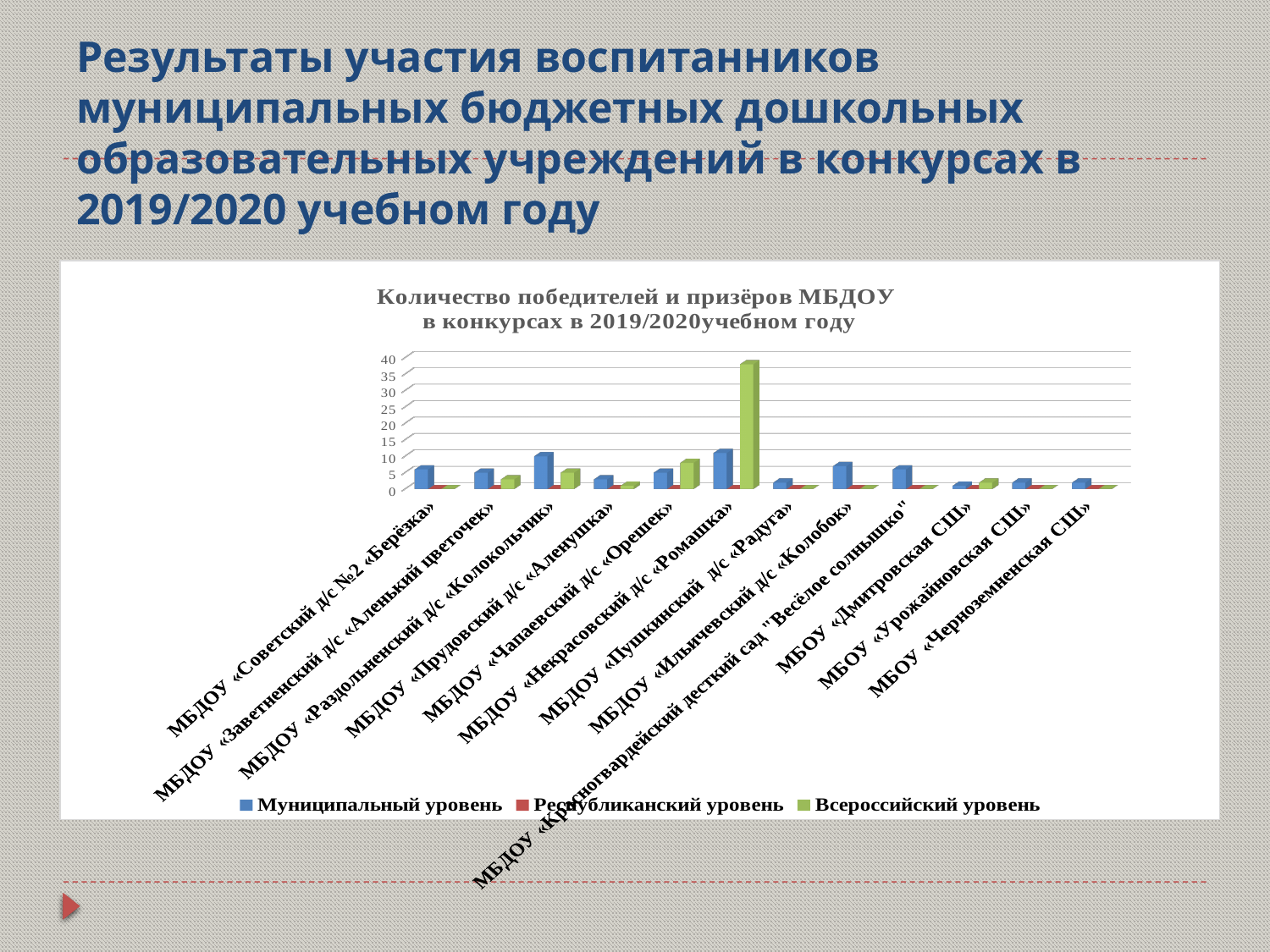
What kind of chart is shown on the slide? Bar chart Which series has the highest value for МБДОУ «Некрасовский д/с «Ромашка»? Всероссийский уровень Which institution has the highest Муниципальный уровень value? МБДОУ «Некрасовский д/с «Ромашка» Which is larger: the Муниципальный уровень value for МБДОУ «Раздольненский д/с «Колокольчик» or for МБДОУ «Прудовский д/с «Аленушка»? МБДОУ «Раздольненский д/с «Колокольчик» Is the Всероссийский уровень value for МБДОУ «Некрасовский д/с «Ромашка» greater or less than 30? greater What is the title of the chart? Количество победителей и призёров МБДОУ в конкурсах в 2019/2020учебном году Which series is shown in green in the legend? Всероссийский уровень Which institution has the tallest bar in the chart? МБДОУ «Некрасовский д/с «Ромашка» Is the Муниципальный уровень value for МБДОУ «Советский д/с №2 «Берёзка» greater or less than 10? less How many series does the legend list? 3 How many institutions (categories) are shown on the x axis? 12 Is the Муниципальный уровень value for МБДОУ «Раздольненский д/с «Колокольчик» greater or less than 5? greater